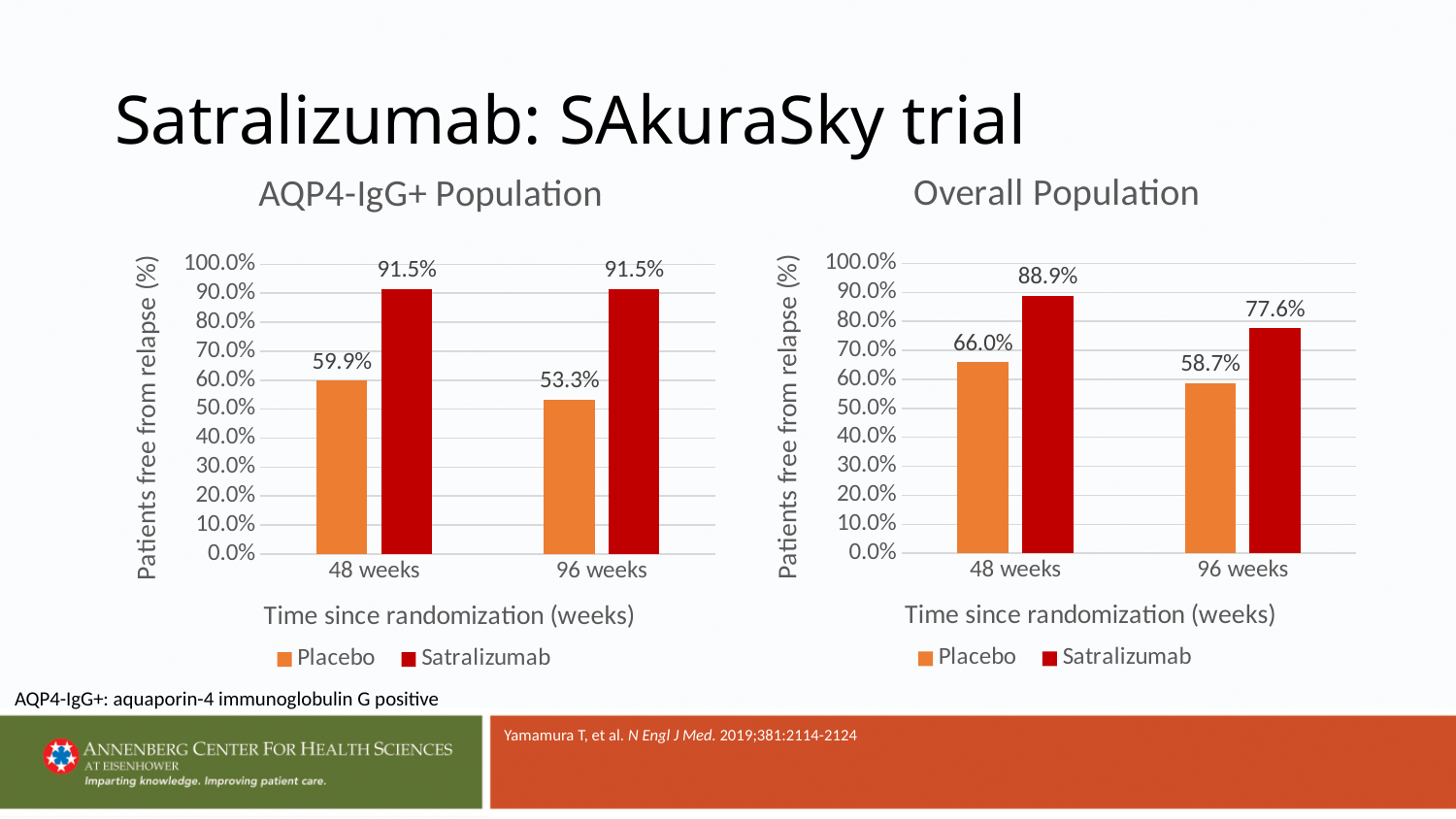
In the AQP4-IgG+ Population chart, what is the difference between Satralizumab and Placebo at 48 weeks? 31.6% In the Overall Population chart, is the value for Placebo at 48 weeks greater or less than 70.0%? less In the Overall Population chart, which bar is the lowest? Placebo at 96 weeks In the Overall Population chart, what is the value for Placebo at 96 weeks? 58.7% How many series does the legend of the AQP4-IgG+ Population chart list? 2 What kind of chart is the Overall Population chart? Bar chart In the AQP4-IgG+ Population chart, what is the value for Satralizumab at 96 weeks? 91.5% In the Overall Population chart, what is the value for Satralizumab at 48 weeks? 88.9% In the Overall Population chart, what is the difference between Satralizumab at 48 weeks and Satralizumab at 96 weeks? 11.3% In the AQP4-IgG+ Population chart, what is the value for Placebo at 48 weeks? 59.9% In the Overall Population chart, do the Placebo values rise or fall from 48 weeks to 96 weeks? Fall In the AQP4-IgG+ Population chart, which is larger: Placebo at 48 weeks or Placebo at 96 weeks? Placebo at 48 weeks